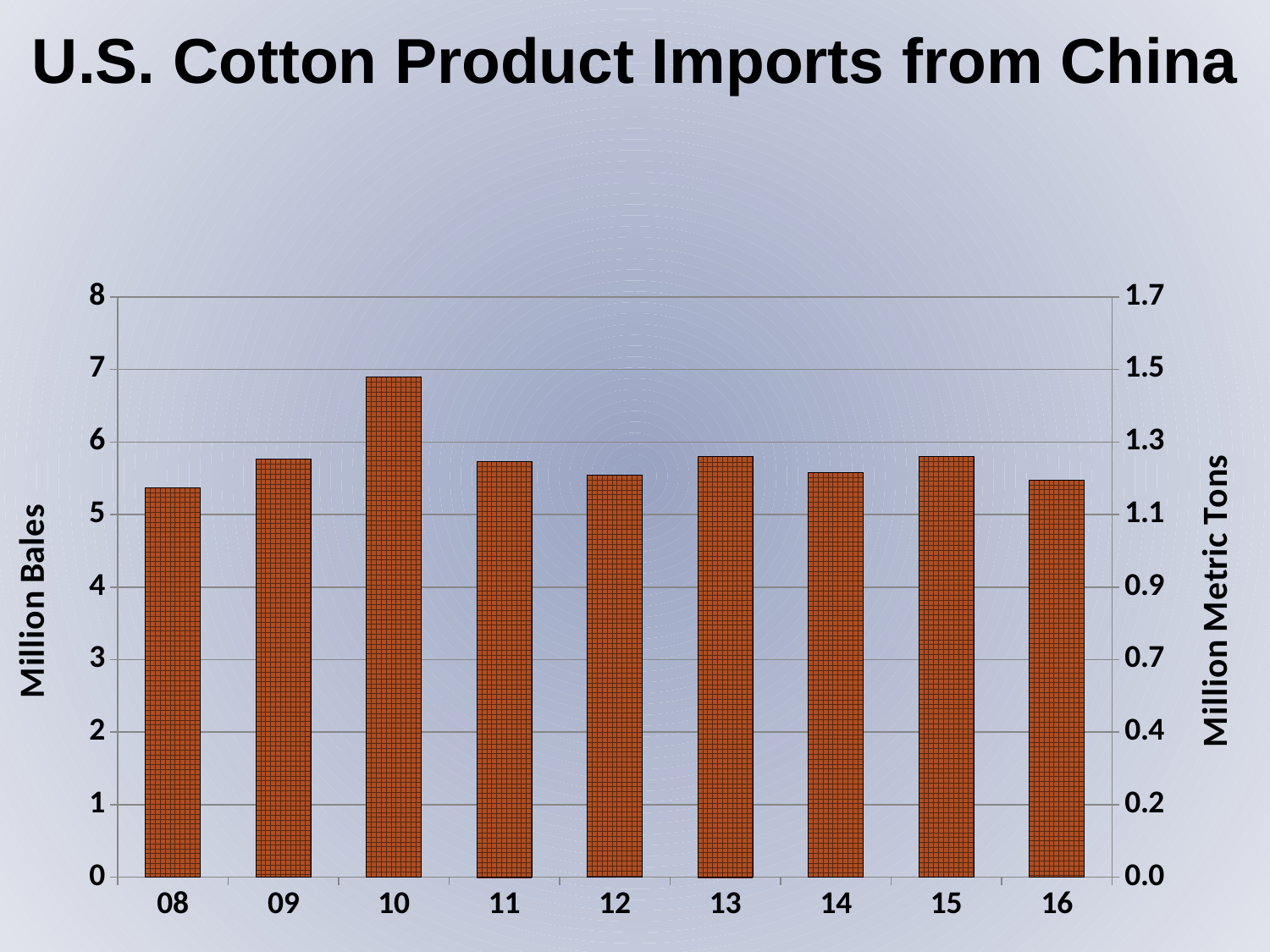
Which is larger, the value for 10 or the value for 11? 10 Is the value for 13 greater or less than 7 million bales? less Which year has the highest U.S. cotton product imports from China? 10 Which is larger, the value for 08 or the value for 09? 09 Is the value for 10 greater or less than 6 million bales? greater Do the values rise or fall from 08 to 10? rise What is the label on the right-hand vertical axis? Million Metric Tons How many years (bars) are plotted on the chart? 9 What kind of chart is shown on the slide? bar chart Is the value for 08 greater or less than 6 million bales? less What is the title of the chart? U.S. Cotton Product Imports from China